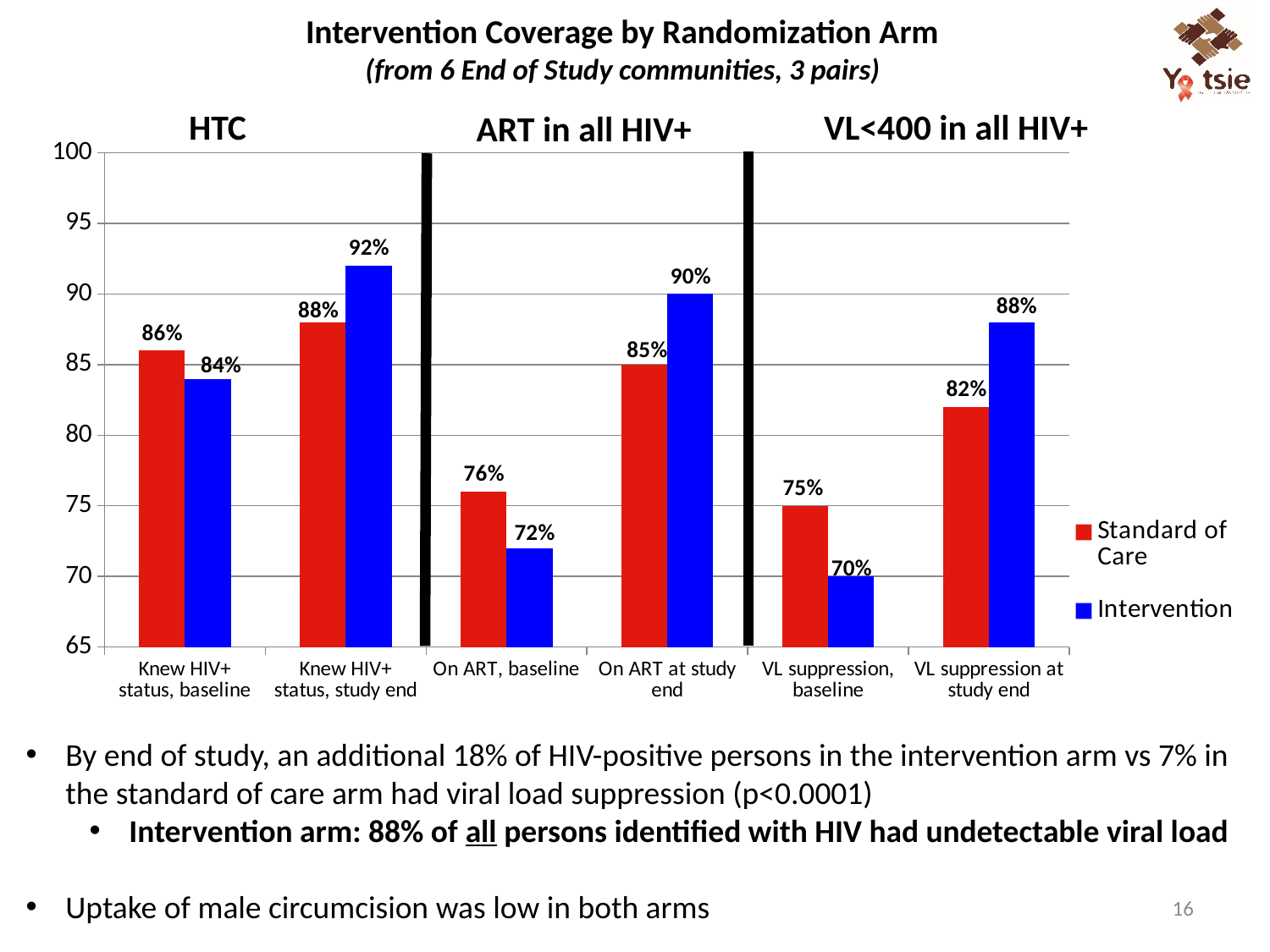
Which category has the highest Intervention value? Knew HIV+ status, study end How many series does the legend list? 2 What kind of chart is shown on the slide? bar chart What is the Intervention value for Knew HIV+ status, study end? 92% For VL suppression, baseline, which is larger: Standard of Care or Intervention? Standard of Care What is the difference between the Intervention and Standard of Care values for On ART at study end? 5% What is the Intervention value for On ART, baseline? 72% How many categories are shown on the x axis? 6 Which category has the lowest Intervention value? VL suppression, baseline Is the Intervention value for VL suppression at study end greater or less than 85? greater What is the Standard of Care value for VL suppression at study end? 82% What is the Standard of Care value for Knew HIV+ status, baseline? 86%